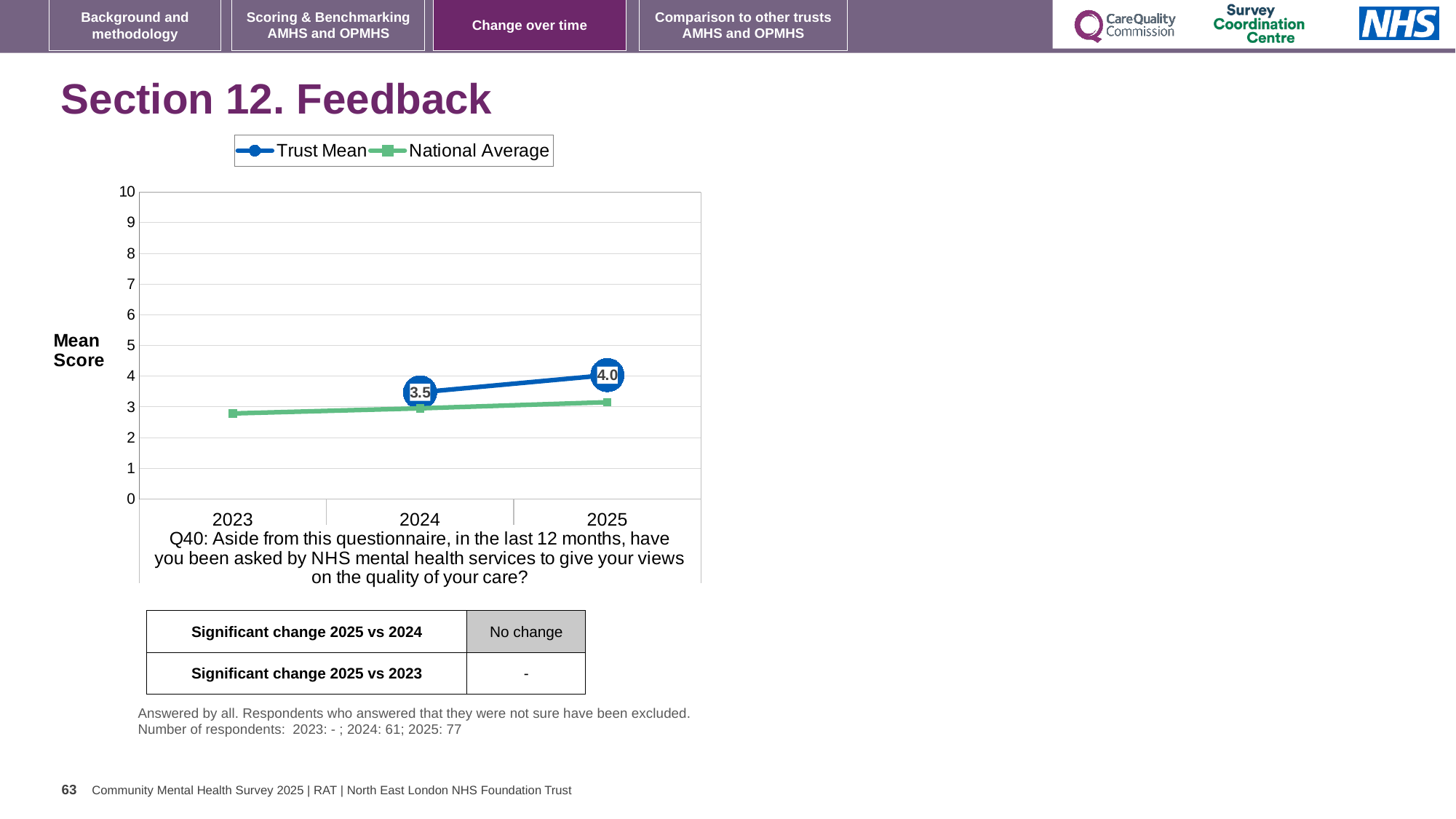
Is the National Average value for 2025 greater or less than 2? greater Is the National Average value for 2023 greater or less than 4? less By how much did the Trust Mean change from 2024 to 2025? 0.5 In 2025, which is higher, the Trust Mean or the National Average? Trust Mean What is the label on the y axis of the chart? Mean Score How many series does the legend list? 2 What is the Trust Mean value for 2024? 3.5 How many years are shown on the x axis? 3 What is the Trust Mean value for 2025? 4.0 Does the Trust Mean rise or fall from 2024 to 2025? rise What kind of chart is shown on the slide? line chart Which year has the higher Trust Mean, 2024 or 2025? 2025